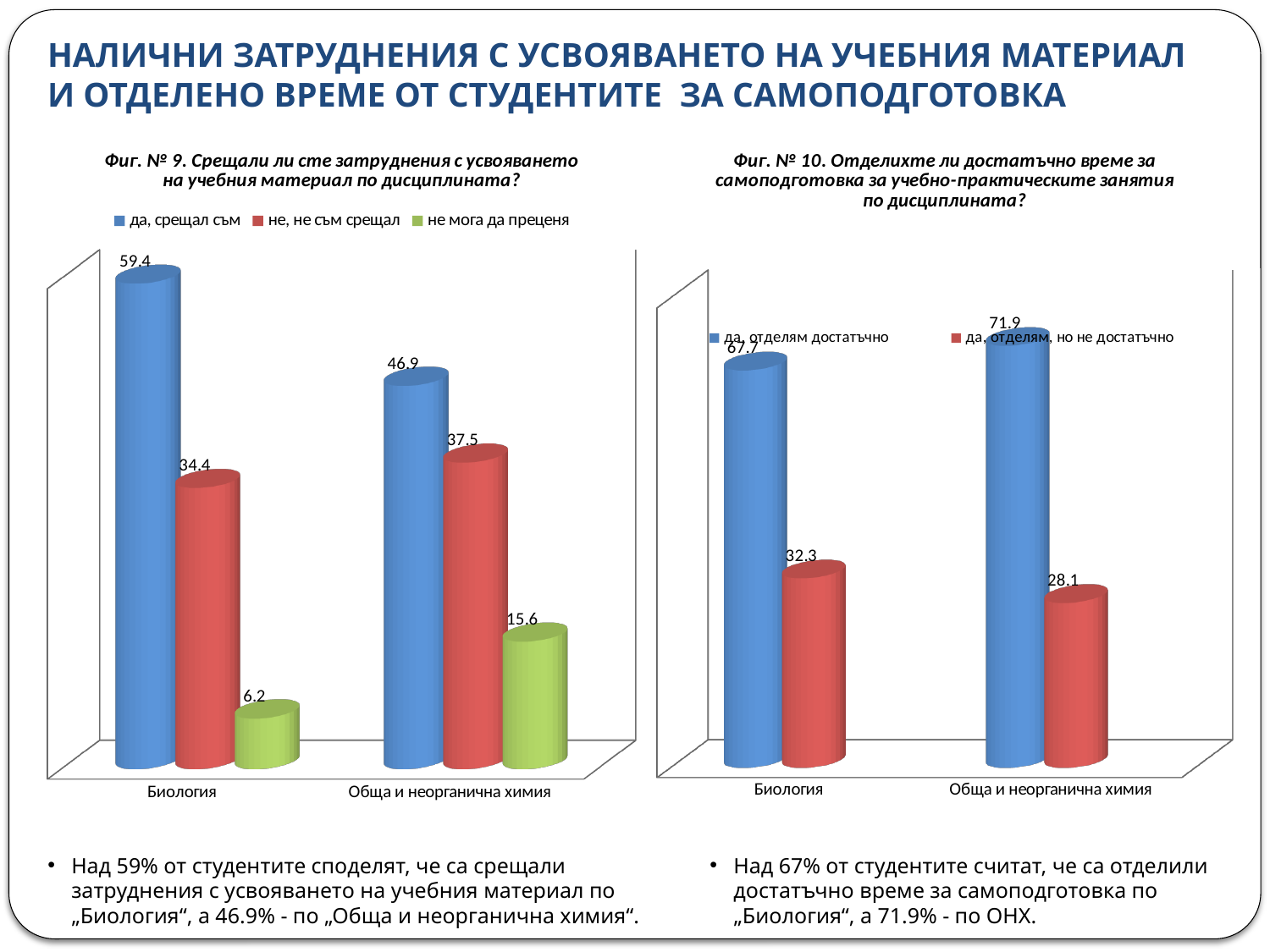
In the chart 'Фиг. № 9', what is the value for 'не мога да преценя' for Обща и неорганична химия? 15.6 In the chart 'Фиг. № 10', how many categories are shown on the x axis? 2 What kind of chart is 'Фиг. № 10'? bar chart In the chart 'Фиг. № 9', which is larger: 'не, не съм срещал' for Биология or for Обща и неорганична химия? Обща и неорганична химия In the chart 'Фиг. № 10', what is the difference between 'да, отделям достатъчно' and 'да, отделям, но не достатъчно' for Обща и неорганична химия? 43.8 In the chart 'Фиг. № 9', what is the value for 'да, срещал съм' for Биология? 59.4 In the chart 'Фиг. № 9', what is the value for 'не, не съм срещал' for Биология? 34.4 In the chart 'Фиг. № 9', how many series does the legend list? 3 In the chart 'Фиг. № 10', what is the value for 'да, отделям достатъчно' for Обща и неорганична химия? 71.9 In the chart 'Фиг. № 10', what is the value for 'да, отделям, но не достатъчно' for Биология? 32.3 In the chart 'Фиг. № 9', which series has the lowest value for Биология? не мога да преценя In the chart 'Фиг. № 9', what is the difference between 'да, срещал съм' for Биология and for Обща и неорганична химия? 12.5